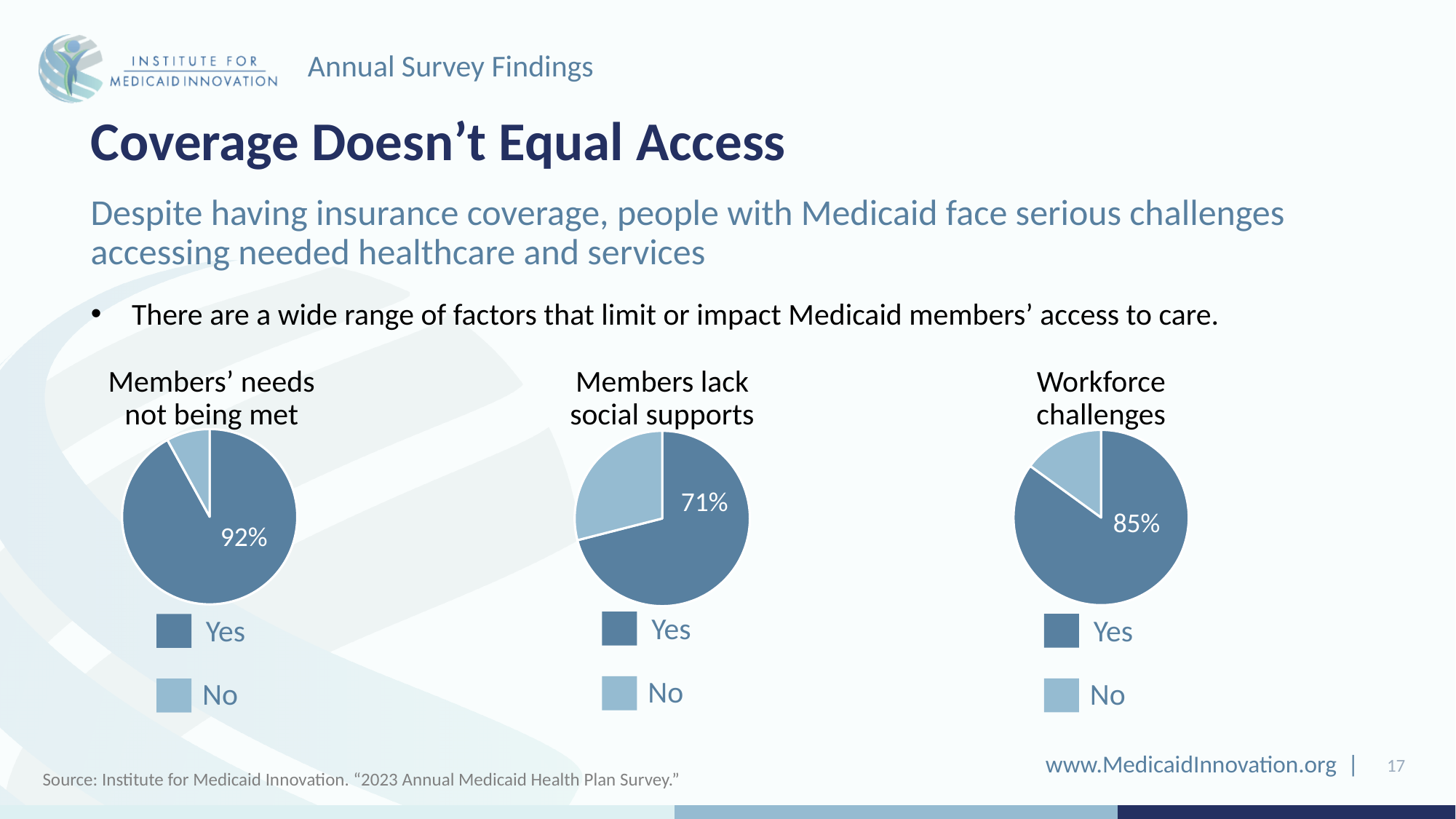
In the 'Workforce challenges' pie chart, what percentage is labeled for the Yes slice? 85% Across the three pie charts, which chart has the highest labeled Yes percentage? Members' needs not being met What type of chart is used for 'Workforce challenges'? Pie chart In the 'Members lack social supports' pie chart, which slice is larger, Yes or No? Yes How many entries does the legend of the 'Members' needs not being met' chart list? 2 What is the difference between the Yes percentage in the 'Members' needs not being met' chart and the Yes percentage in the 'Members lack social supports' chart? 21% What is the difference between the Yes percentage in the 'Workforce challenges' chart and the Yes percentage in the 'Members lack social supports' chart? 14% How many pie charts are shown on the slide? 3 Across the three pie charts, which chart has the lowest labeled Yes percentage? Members lack social supports Which chart has a larger Yes percentage, 'Workforce challenges' or 'Members' needs not being met'? Members' needs not being met In the 'Members lack social supports' pie chart, what percentage is labeled for the Yes slice? 71% In the 'Members' needs not being met' pie chart, what percentage is labeled for the Yes slice? 92%